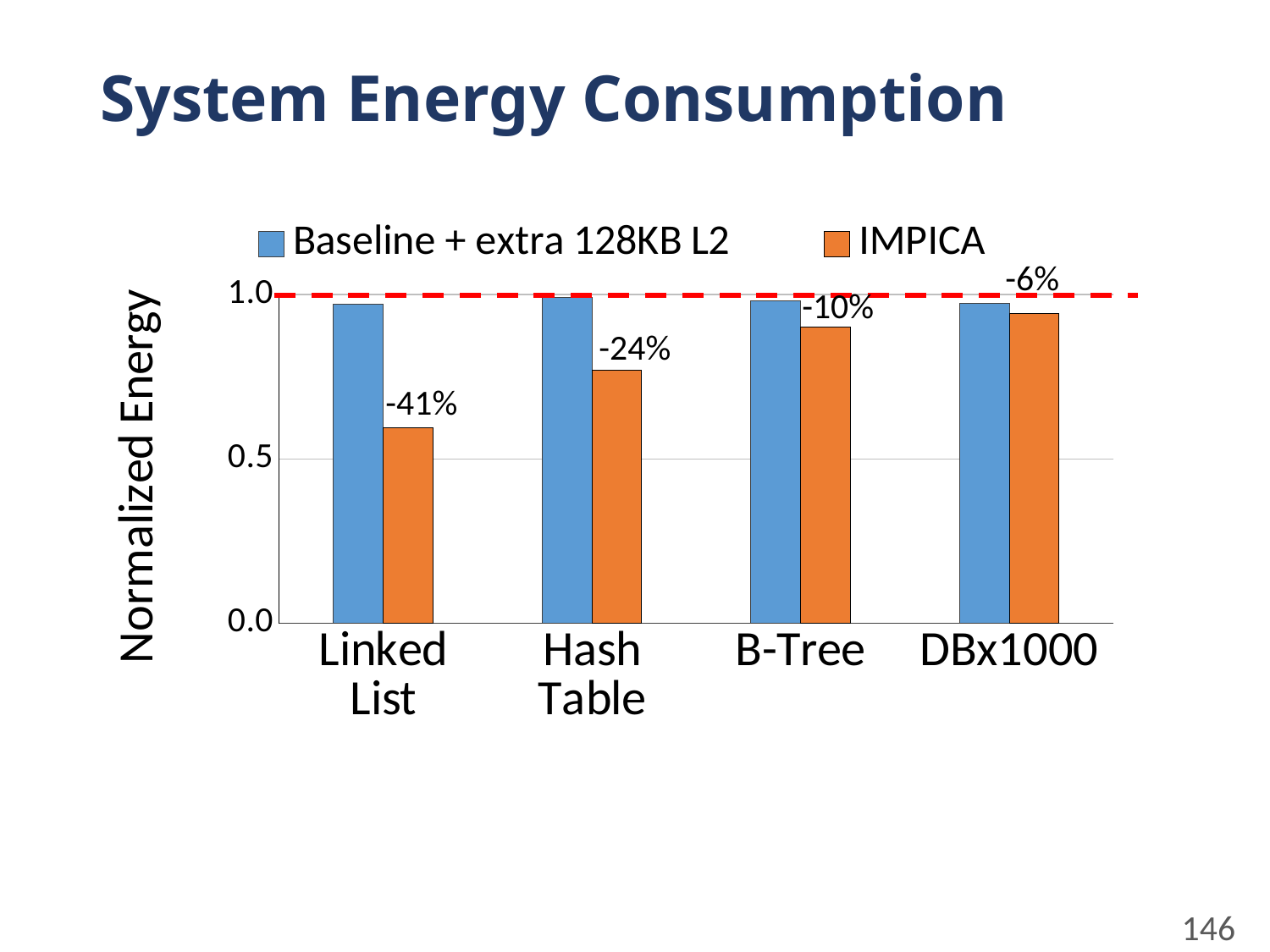
What percentage reduction is labeled on the IMPICA bar for Hash Table? -24% How many series does the legend list? 2 What kind of chart is shown on the slide? bar chart Which category has the lowest IMPICA normalized energy? Linked List What percentage reduction is labeled on the IMPICA bar for DBx1000? -6% How many categories are shown on the x axis? 4 What is the label of the y axis? Normalized Energy Which is larger: the IMPICA value for Linked List or the IMPICA value for Hash Table? Hash Table What percentage reduction is labeled on the IMPICA bar for B-Tree? -10% Is the IMPICA value for Linked List greater or less than 0.5? greater What percentage reduction is labeled on the IMPICA bar for Linked List? -41% Which is larger for Linked List: the Baseline + extra 128KB L2 value or the IMPICA value? Baseline + extra 128KB L2